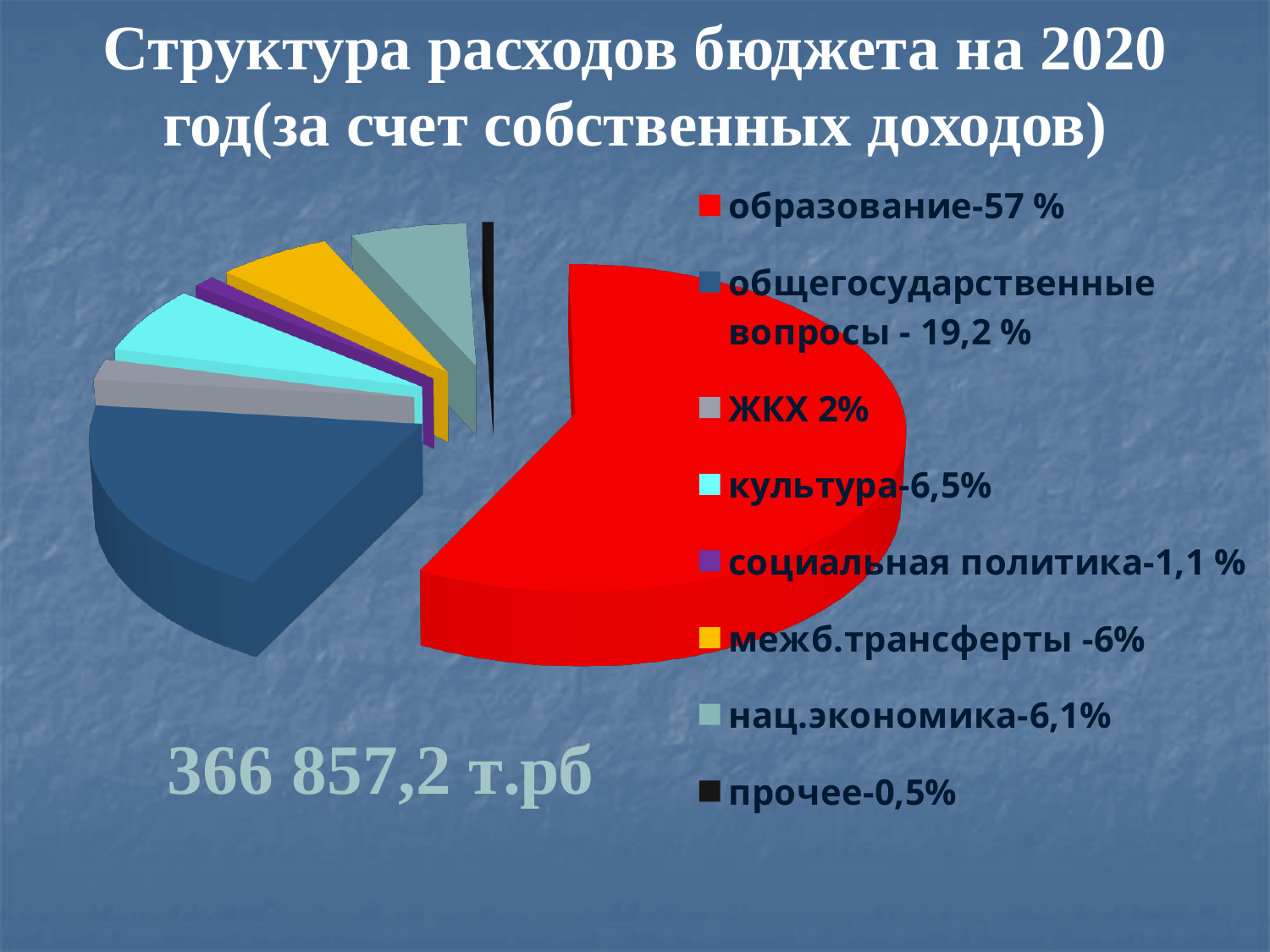
What colour is the slice for ЖКХ in the pie chart? grey What total amount is printed below the pie chart? 366 857,2 т.рб Which is larger, the share for межб.трансферты or the share for нац.экономика? нац.экономика Which category has the smallest share of the pie chart? прочее How many categories does the legend of the pie chart list? 8 What is the value shown for культура? 6,5% What is the value shown for социальная политика? 1,1 % What share of the pie does образование have? 57 % Which category has the largest share of the pie chart? образование What kind of chart is shown on the slide? pie chart What share of the pie does общегосударственные вопросы have? 19,2 % What is the difference between the shares of образование and общегосударственные вопросы? 37,8 %